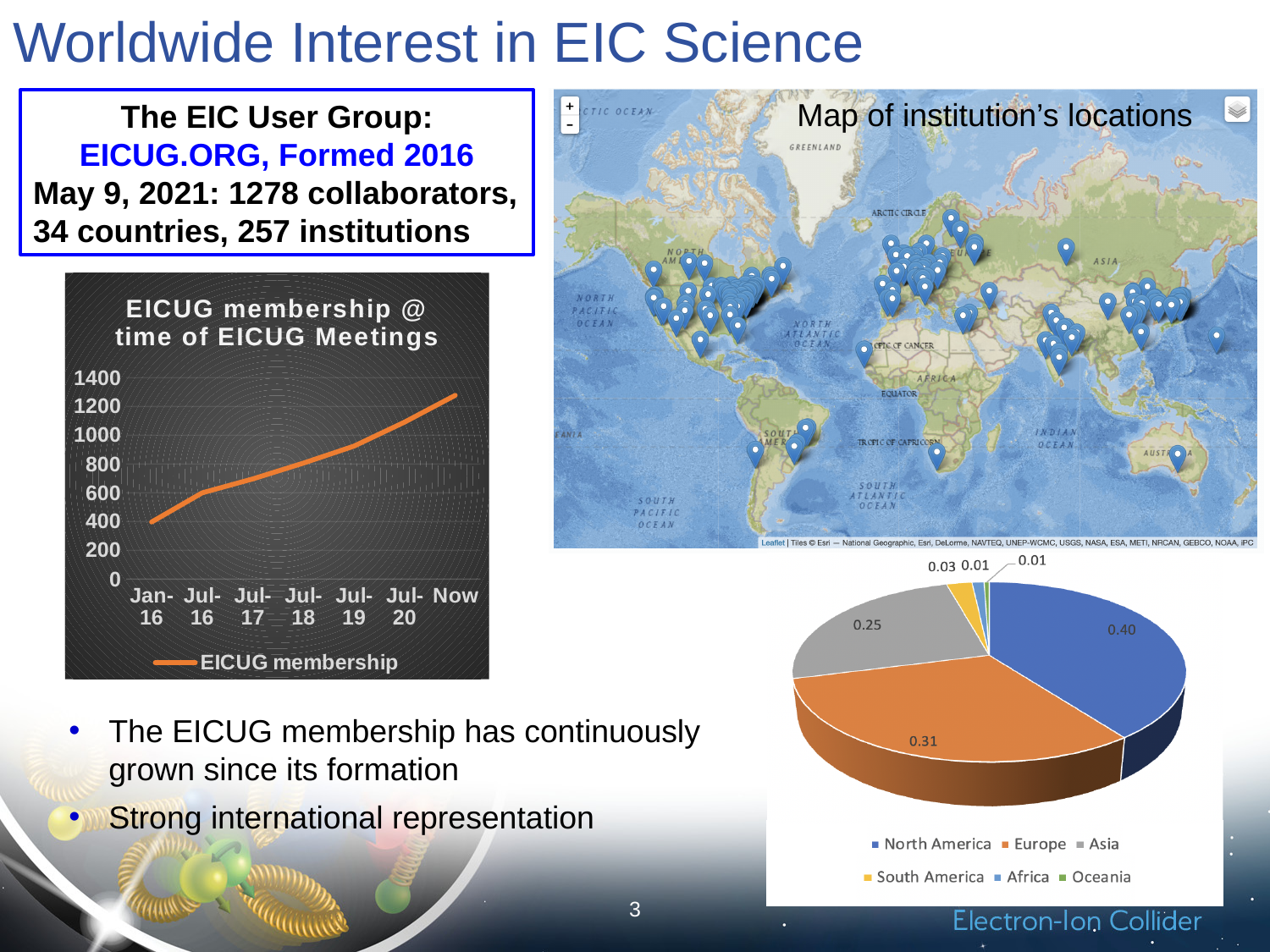
In the 'EICUG membership @ time of EICUG Meetings' chart, is the value for Jul-18 greater or less than 600? greater In the 'EICUG membership @ time of EICUG Meetings' chart, how many series does the legend list? 1 In the 'EICUG membership @ time of EICUG Meetings' chart, does the membership rise or fall from Jan-16 to Now? rise In the 'EICUG membership @ time of EICUG Meetings' chart, is the value for Now greater or less than 1000? greater In the pie chart at the bottom right, what share does North America have? 0.40 In the 'EICUG membership @ time of EICUG Meetings' chart, how many points are plotted along the x axis? 7 In the pie chart at the bottom right, what share does South America have? 0.03 In the 'EICUG membership @ time of EICUG Meetings' chart, what kind of chart is shown? line chart In the 'EICUG membership @ time of EICUG Meetings' chart, is the value for Jan-16 greater or less than 600? less In the pie chart at the bottom right, which region has the largest slice? North America In the pie chart at the bottom right, what is the difference between the North America and Europe shares? 0.09 In the pie chart at the bottom right, how many regions does the legend list? 6